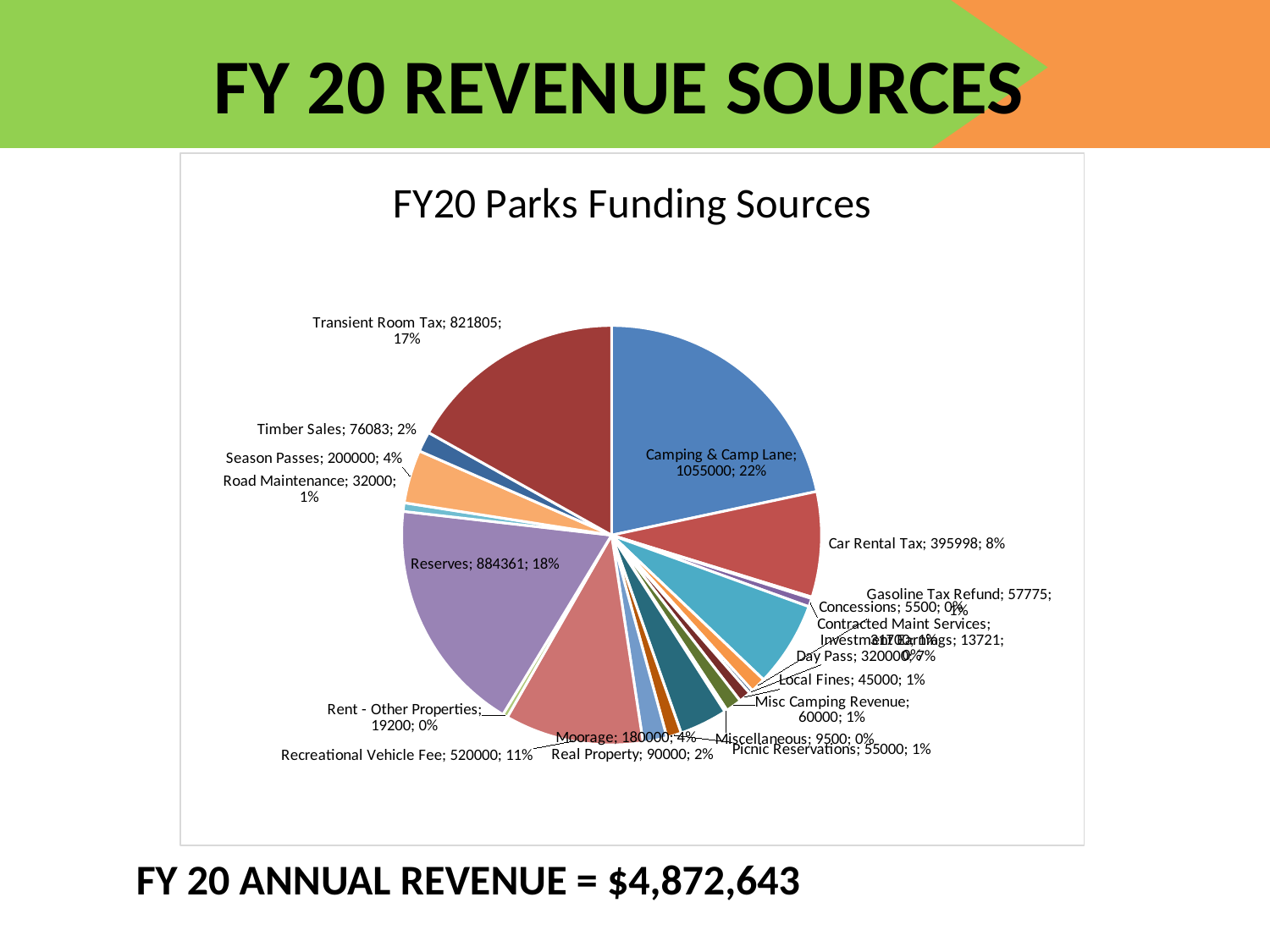
What is the value for Car Rental Tax? 395998 Which funding source has the largest slice of the pie? Camping & Camp Lane What is the value for Moorage? 180000 What is the value for Camping & Camp Lane? 1055000 Which is larger, Season Passes or Timber Sales? Season Passes What type of chart is shown on the slide? Pie chart What share of the pie does Reserves represent? 18% What is the difference between the values for Reserves and Transient Room Tax? 62556 What is the title of the chart? FY20 Parks Funding Sources What is the value for Transient Room Tax? 821805 What share of the pie does Real Property represent? 2% What share of the pie does Recreational Vehicle Fee represent? 11%